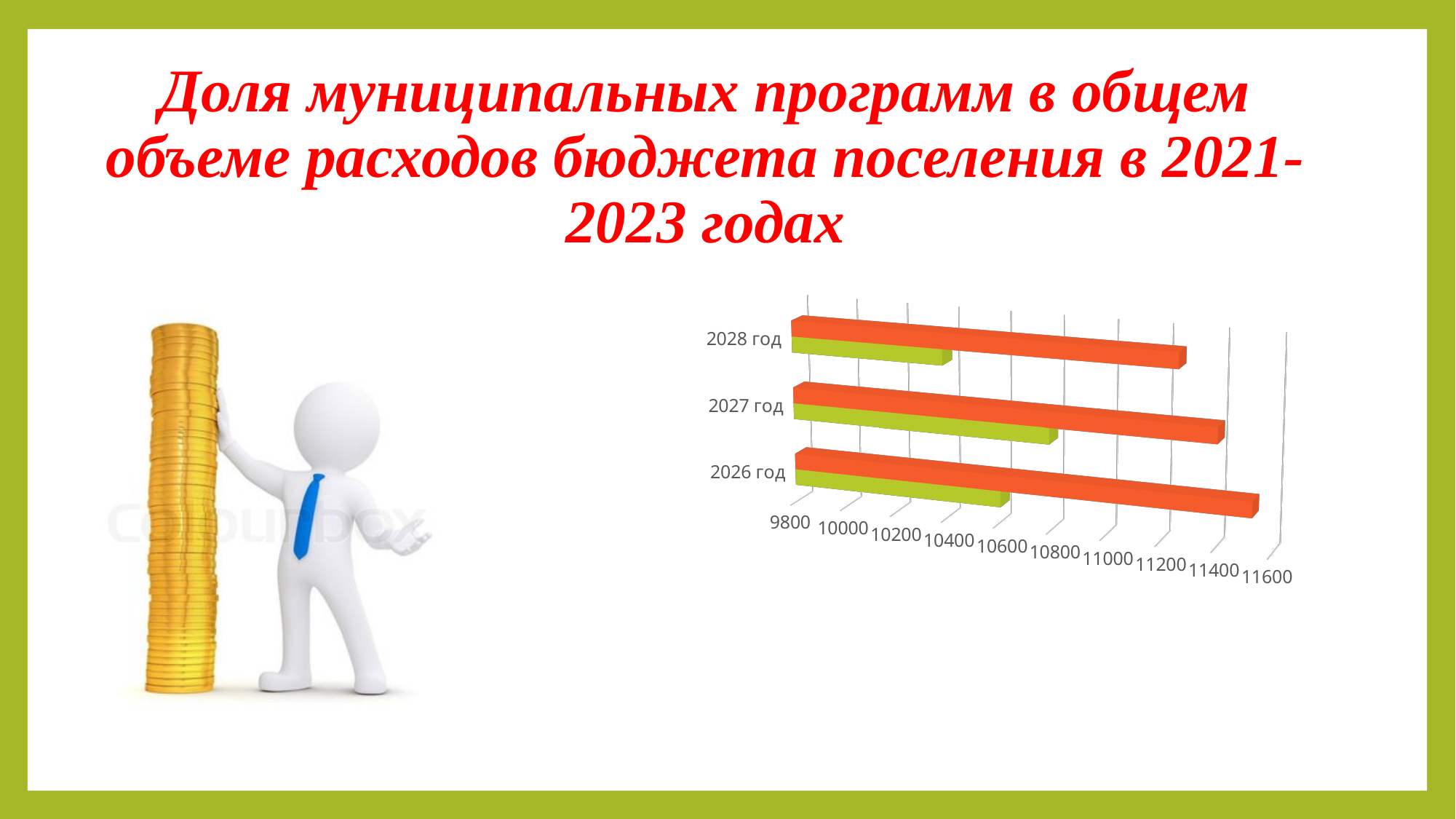
Which year has the longest green bar on the chart? 2027 год Is the value of the green bar for 2028 год greater or less than 10600? less Which year has the shortest green bar on the chart? 2028 год Is the value of the orange bar for 2028 год greater or less than 11000? greater How many data series (bar colours) are plotted for each year on the chart? 2 What kind of chart is shown on the slide? bar chart Is the value of the orange bar for 2026 год greater or less than 11200? greater For 2027 год, which bar is longer, the orange one or the green one? orange Which year has the longest orange bar on the chart? 2026 год Do the orange bars rise or fall from 2026 год to 2028 год? fall How many year categories are shown on the chart? 3 Which year has the shortest orange bar on the chart? 2028 год